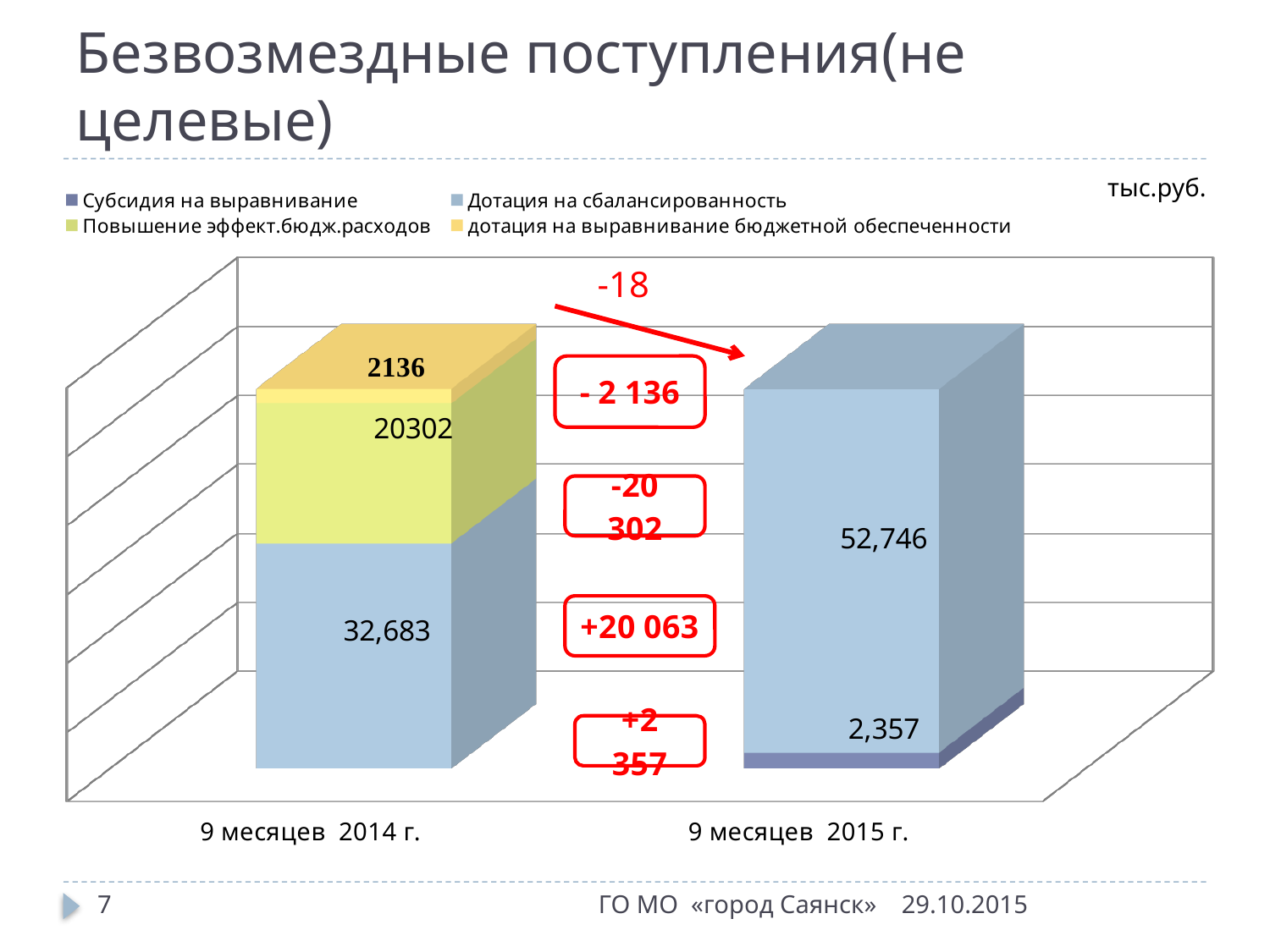
What is the total of the stacked bar for 9 месяцев 2015 г.? 55,103 How many series does the legend list? 4 What is the value of Дотация на сбалансированность for 9 месяцев 2014 г.? 32,683 What type of chart is shown on the slide? stacked bar chart Which category has the larger value for Дотация на сбалансированность, 9 месяцев 2014 г. or 9 месяцев 2015 г.? 9 месяцев 2015 г. What is the value of дотация на выравнивание бюджетной обеспеченности for 9 месяцев 2014 г.? 2136 What is the value of Повышение эффект.бюдж.расходов for 9 месяцев 2014 г.? 20302 By how much does Дотация на сбалансированность for 9 месяцев 2015 г. exceed that for 9 месяцев 2014 г.? 20,063 What is the value of Дотация на сбалансированность for 9 месяцев 2015 г.? 52,746 How many categories are shown on the x axis? 2 What is the value of Субсидия на выравнивание for 9 месяцев 2015 г.? 2,357 What unit is indicated for the chart values? тыс.руб.